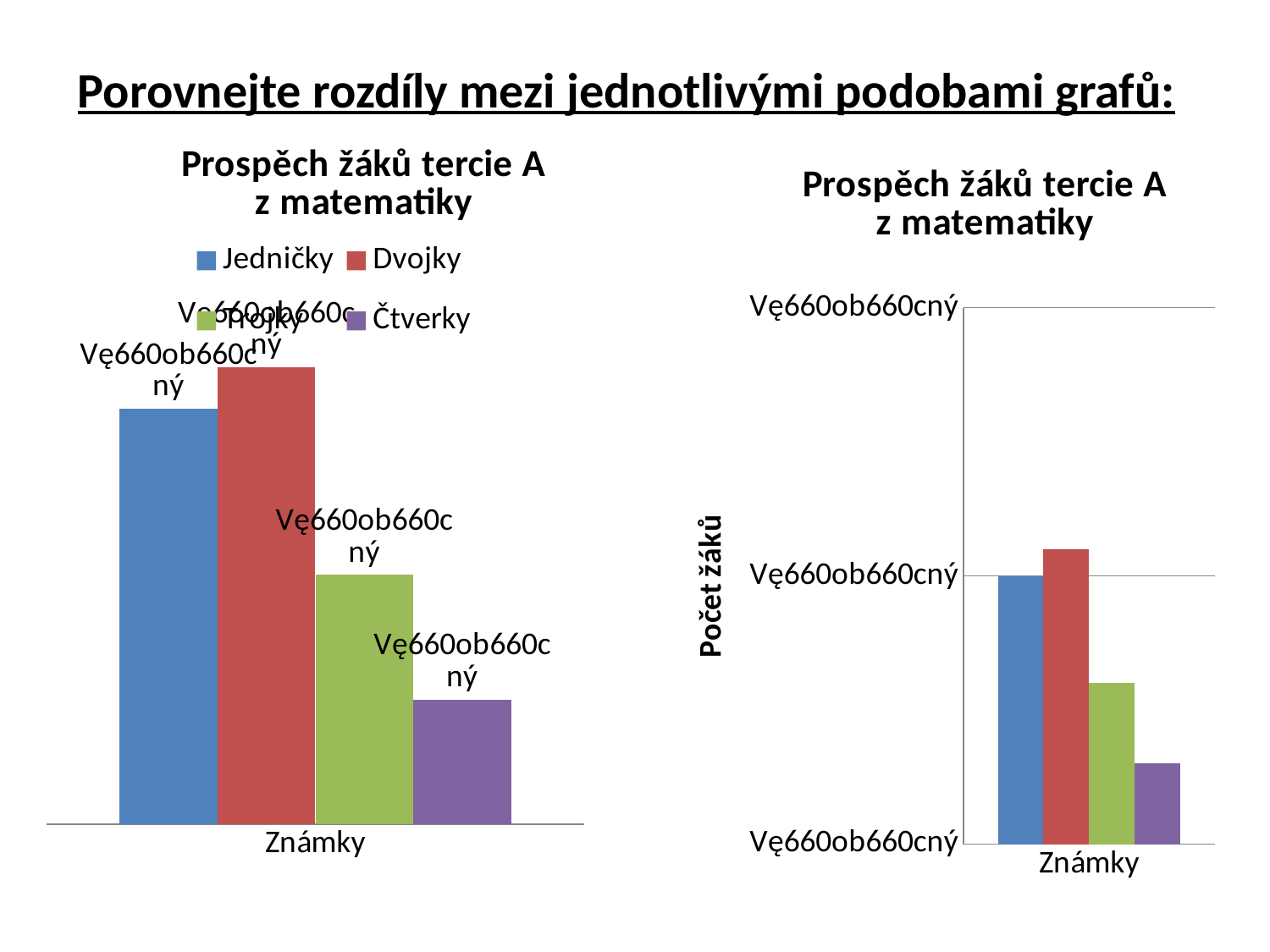
What kind of chart is the right chart, 'Prospěch žáků tercie A z matematiky'? bar chart What kind of chart is the left chart, 'Prospěch žáků tercie A z matematiky'? bar chart In the left chart, how many bars are plotted? 4 In the left chart, what is the category label shown on the horizontal axis? Známky In the right chart, which bar is the shortest? the purple (fourth) bar In the right chart, what is the title of the vertical axis? Počet žáků In the left chart, which series has the tallest bar? Dvojky In the left chart, which series has the shortest bar? Čtverky In the right chart, which bar is the tallest? the red (second) bar In the left chart, how many series does the legend list? 4 In the left chart, which is larger, Jedničky or Trojky? Jedničky In the left chart, which is larger, Dvojky or Čtverky? Dvojky